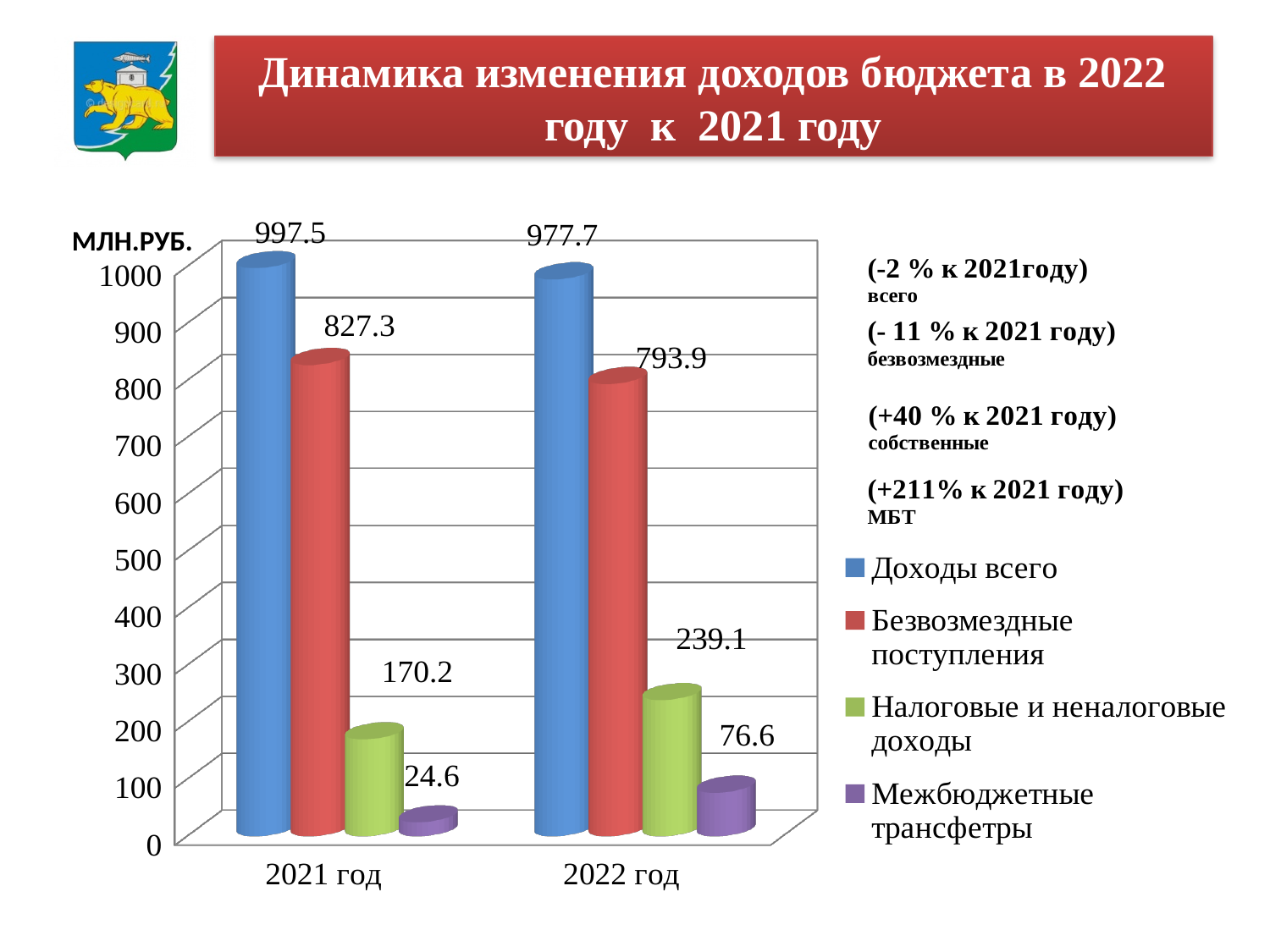
What is the value of Налоговые и неналоговые доходы for 2022 год? 239.1 Which series has the highest value for 2021 год? Доходы всего What is the value of Доходы всего for 2021 год? 997.5 What is the difference between Налоговые и неналоговые доходы for 2022 год and 2021 год? 68.9 What is the value of Безвозмездные поступления for 2022 год? 793.9 Which series has the lowest value for 2022 год? Межбюджетные трансфетры Which is larger: Межбюджетные трансфетры for 2021 год or for 2022 год? 2022 год What kind of chart is shown on the slide? Bar chart How many categories are shown on the x axis? 2 What is the value of Межбюджетные трансфетры for 2021 год? 24.6 What is the difference between Доходы всего for 2021 год and 2022 год? 19.8 How many series does the legend list? 4